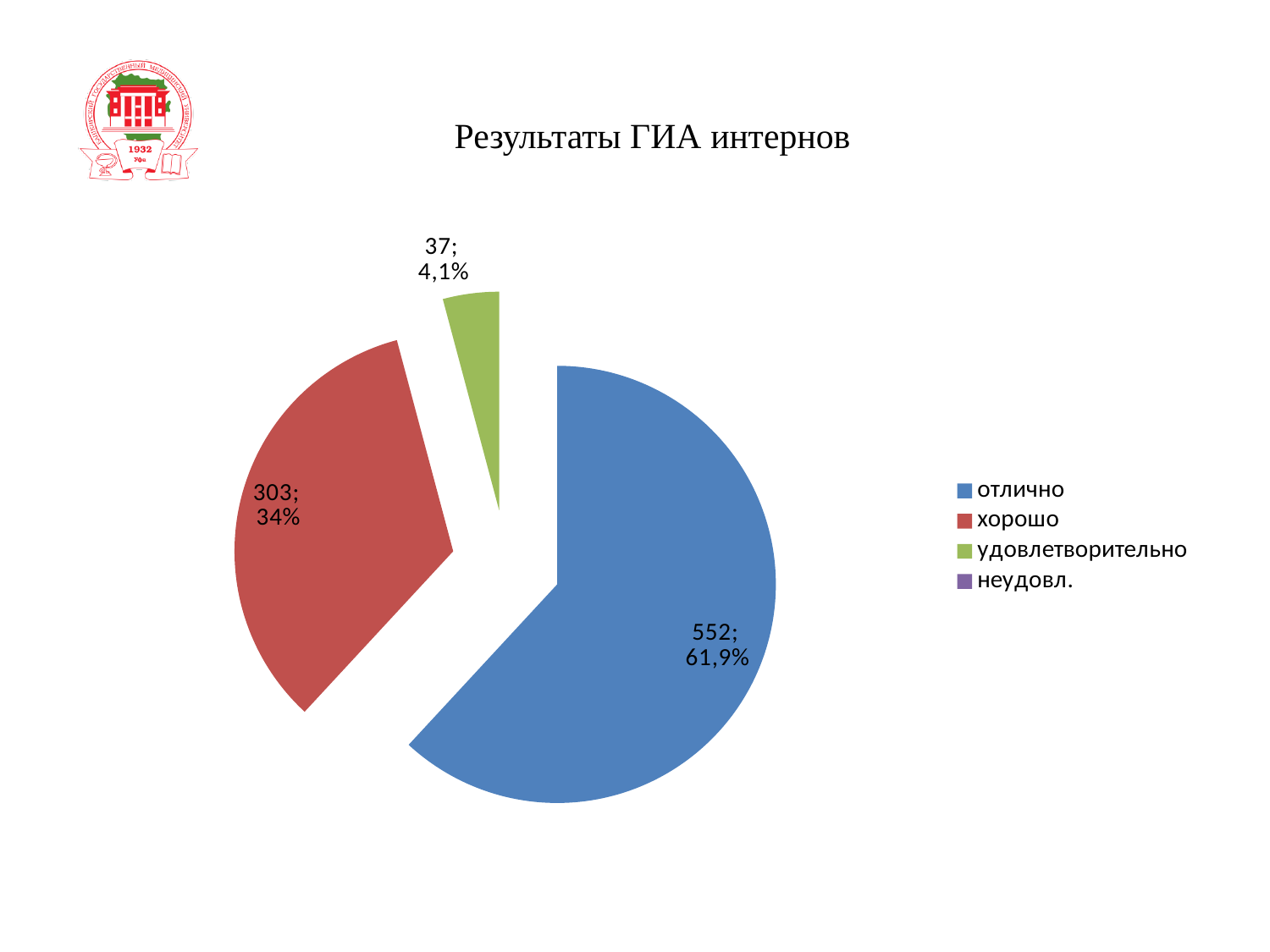
What share of the pie does удовлетворительно represent? 4,1% Which category has the largest slice? отлично Which of the visible slices is the smallest? удовлетворительно How many entries does the legend list? 4 What is the value for хорошо? 303 What is the value for отлично? 552 What is the title of the chart? Результаты ГИА интернов What type of chart is shown on the slide? pie chart What is the value for удовлетворительно? 37 What share of the pie does хорошо represent? 34% What is the difference between the values for отлично and хорошо? 249 What share of the pie does отлично represent? 61,9%